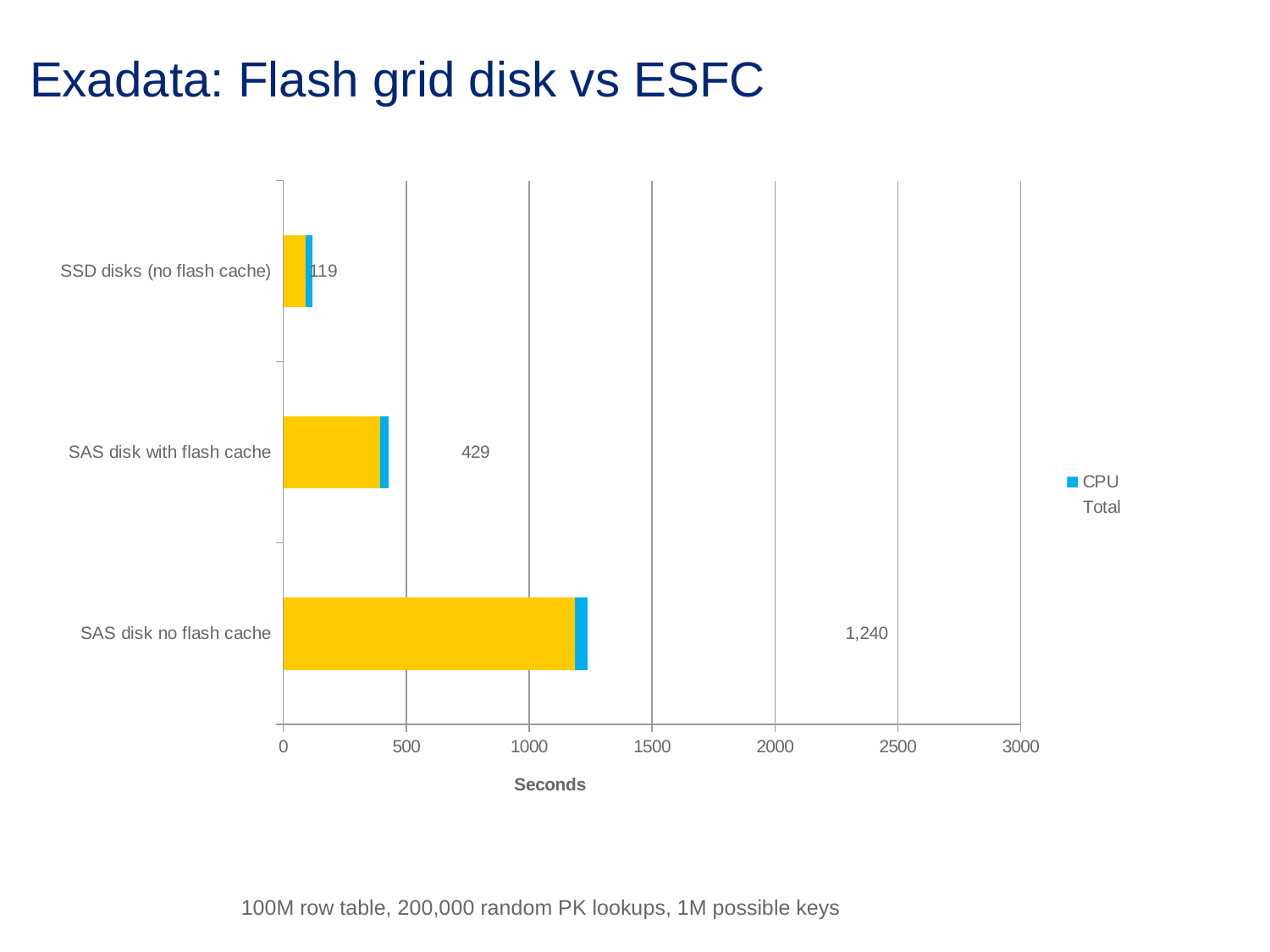
What kind of chart is shown on the slide? Bar chart Which category has the highest labelled value? SAS disk no flash cache What is the difference between the labelled values for SAS disk with flash cache and SSD disks (no flash cache)? 310 How many series does the legend list? 2 What is the difference between the labelled values for SAS disk no flash cache and SAS disk with flash cache? 811 What value is labelled for SSD disks (no flash cache)? 119 How many categories are shown on the chart? 3 Which category has the lowest labelled value? SSD disks (no flash cache) Is the value for SAS disk no flash cache greater or less than 1000? greater Which is larger, the labelled value for SAS disk with flash cache or for SSD disks (no flash cache)? SAS disk with flash cache What value is labelled for SAS disk no flash cache? 1,240 What value is labelled for SAS disk with flash cache? 429